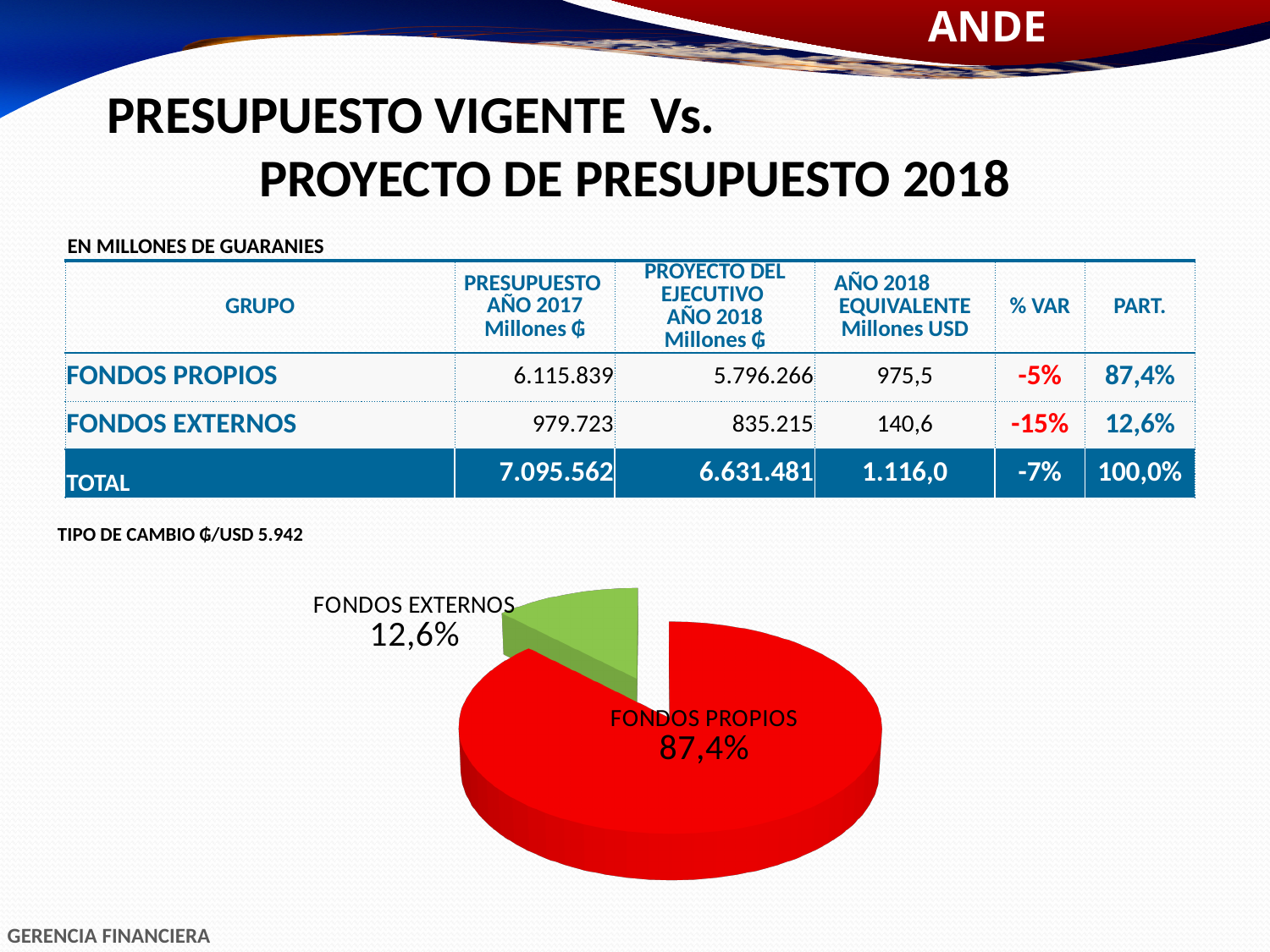
What is the value printed on the FONDOS EXTERNOS slice of the pie chart? 12,6% What colour is the FONDOS EXTERNOS slice in the pie chart? green What is the value printed on the FONDOS PROPIOS slice of the pie chart? 87,4% In the pie chart, which is larger: FONDOS PROPIOS or FONDOS EXTERNOS? FONDOS PROPIOS How many slices does the pie chart have? 2 Which slice of the pie chart is the largest? FONDOS PROPIOS What share of the pie chart does FONDOS PROPIOS represent? 87,4% What colour is the FONDOS PROPIOS slice in the pie chart? red What share of the pie chart does FONDOS EXTERNOS represent? 12,6% What kind of chart is shown on the slide? pie chart Which slice of the pie chart is the smallest? FONDOS EXTERNOS What is the difference in percentage points between the FONDOS PROPIOS and FONDOS EXTERNOS slices of the pie chart? 74,8%